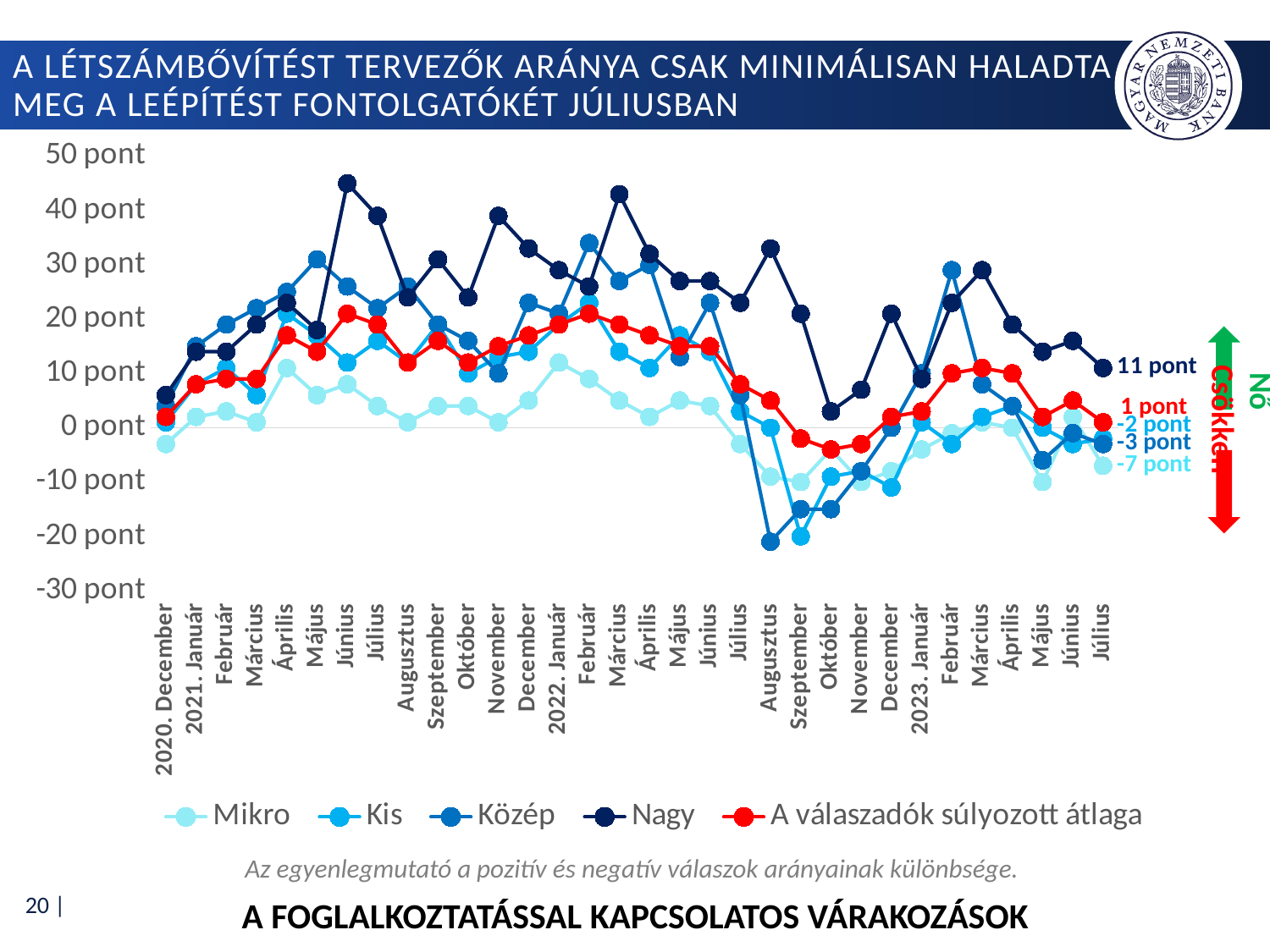
How many series does the legend list? 5 Is the value for the Nagy series in 2021 Június greater or less than 40 pont? greater What is the difference between the Nagy and Mikro values in 2023 Július? 18 pont What is the value for 'A válaszadók súlyozott átlaga' in 2023 Július? 1 pont What is the value for the Kis series in 2023 Július? -2 pont Is the value for the Kis series in 2022 Augusztus greater or less than -10 pont? greater What kind of chart is shown on the slide? line chart What is the value for the Közép series in 2023 Július? -3 pont How many months are shown on the x axis? 32 Which series has the highest value in 2023 Július? Nagy What is the value for the Nagy series in 2023 Július? 11 pont What is the value for the Mikro series in 2023 Július? -7 pont